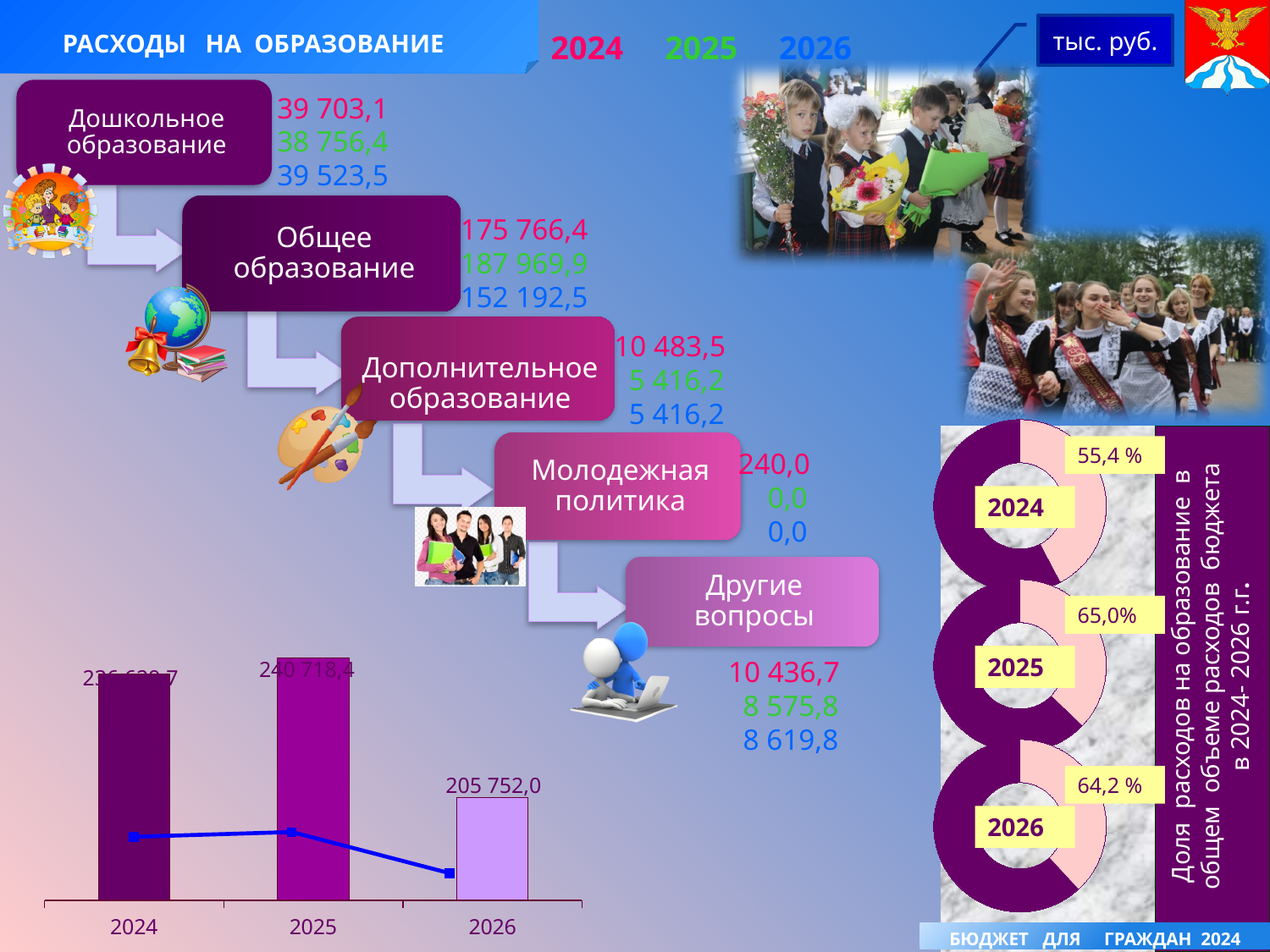
In the bar chart at the bottom left, which is larger, the value for 2024 or the value for 2026? 2024 In what units are the values on the slide expressed, according to the box at the top right? тыс. руб. In the bar chart at the bottom left, what is the value for 2025? 240 718,4 In the graphic on the right showing the share of education spending in total budget expenditure, what is the share for 2025? 65,0% What kind of chart is shown at the bottom left of the slide? bar chart In the bar chart at the bottom left, which year has the lowest bar? 2026 In the bar chart at the bottom left, do the values rise or fall from 2025 to 2026? fall In the bar chart at the bottom left, what is the value for 2026? 205 752,0 How many years are shown on the x axis of the bar chart at the bottom left? 3 In the bar chart at the bottom left, which is larger, the value for 2025 or the value for 2026? 2025 In the bar chart at the bottom left, which year has the highest bar? 2025 In the bar chart at the bottom left, what is the difference between the values for 2025 and 2026? 34 966,4